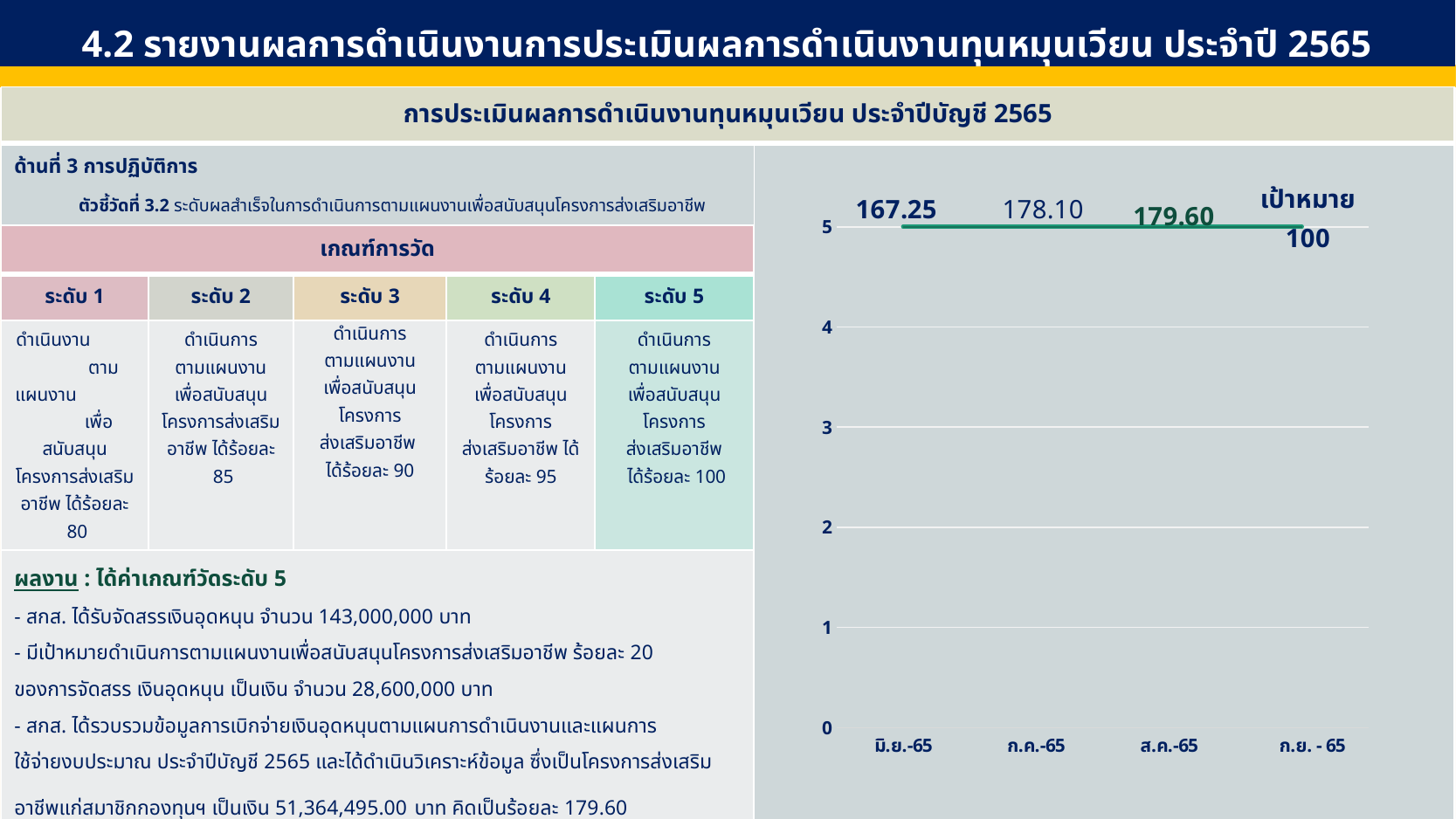
Which is larger, the data label for ก.ค.-65 or for ส.ค.-65? ส.ค.-65 Which month has the highest printed data label on the chart? ส.ค.-65 What is the data label printed above มิ.ย.-65 on the chart? 167.25 What kind of chart is shown on the right side of the slide? line chart Does the plotted line rise, fall, or stay flat across the months on the x axis? stays flat What target value (เป้าหมาย) is printed on the chart? 100 What is the data label printed above ส.ค.-65 on the chart? 179.60 What is the difference between the data labels for ส.ค.-65 and มิ.ย.-65? 12.35 What is the data label printed above ก.ค.-65 on the chart? 178.10 Is the plotted level for มิ.ย.-65 greater or less than 4 on the y axis? greater Which month has the lowest printed data label on the chart? มิ.ย.-65 How many months are labelled on the x axis of the chart? 4